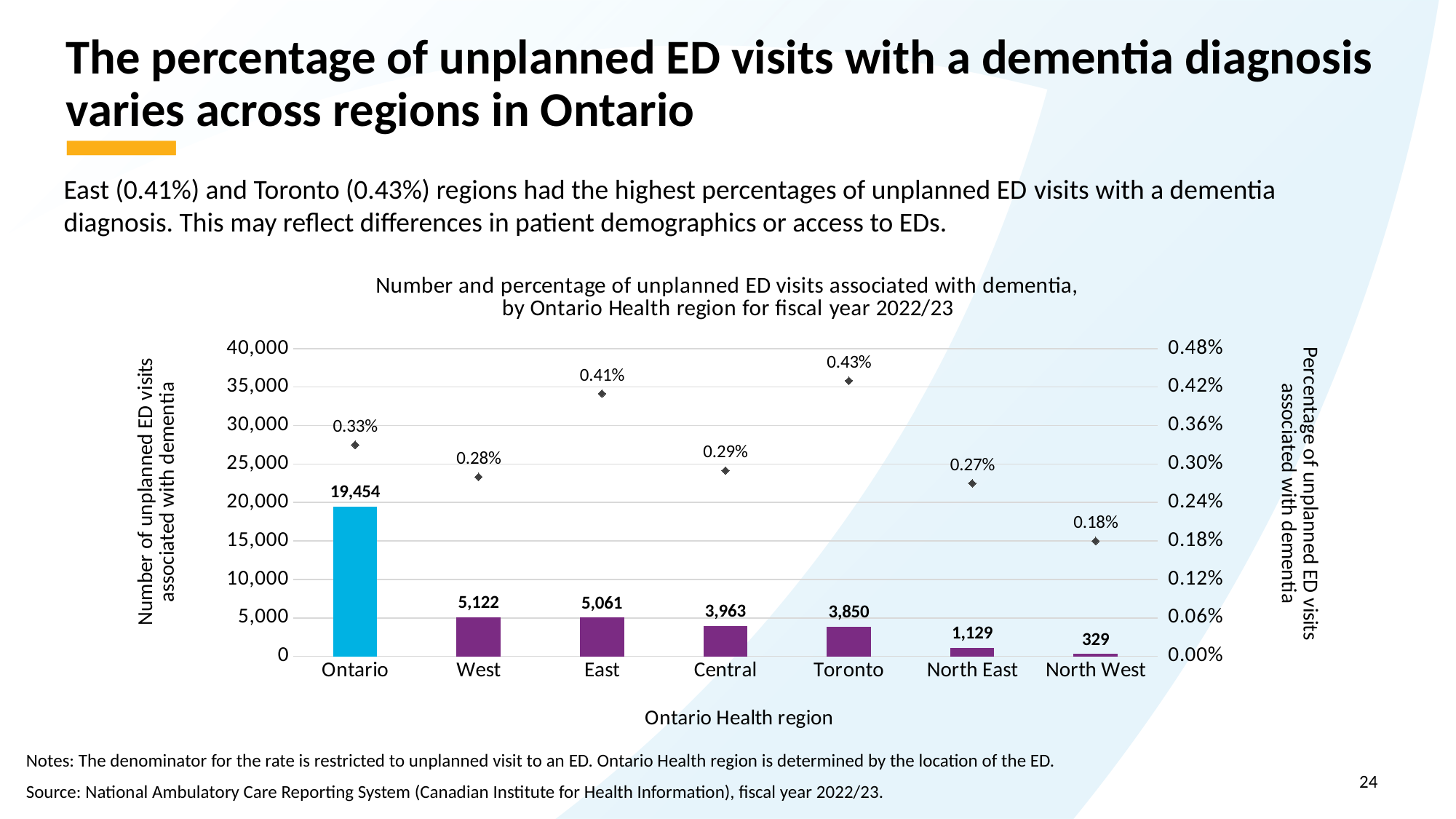
Excluding Ontario, which region has the highest number of unplanned ED visits associated with dementia? West What is the number of unplanned ED visits associated with dementia for North West? 329 How many regions are shown on the x axis of the chart? 7 Which has a higher percentage of unplanned ED visits associated with dementia, Central or North East? Central What is the number of unplanned ED visits associated with dementia for Ontario? 19,454 What is the difference in the number of unplanned ED visits associated with dementia between West and East? 61 What is the label of the x axis of the chart? Ontario Health region Which region has the lowest percentage of unplanned ED visits associated with dementia? North West What is the difference in percentage of unplanned ED visits associated with dementia between Toronto and North West? 0.25% What kind of chart is used to show the number of unplanned ED visits associated with dementia? Bar chart Which region has the highest percentage of unplanned ED visits associated with dementia? Toronto What is the percentage of unplanned ED visits associated with dementia for Toronto? 0.43%